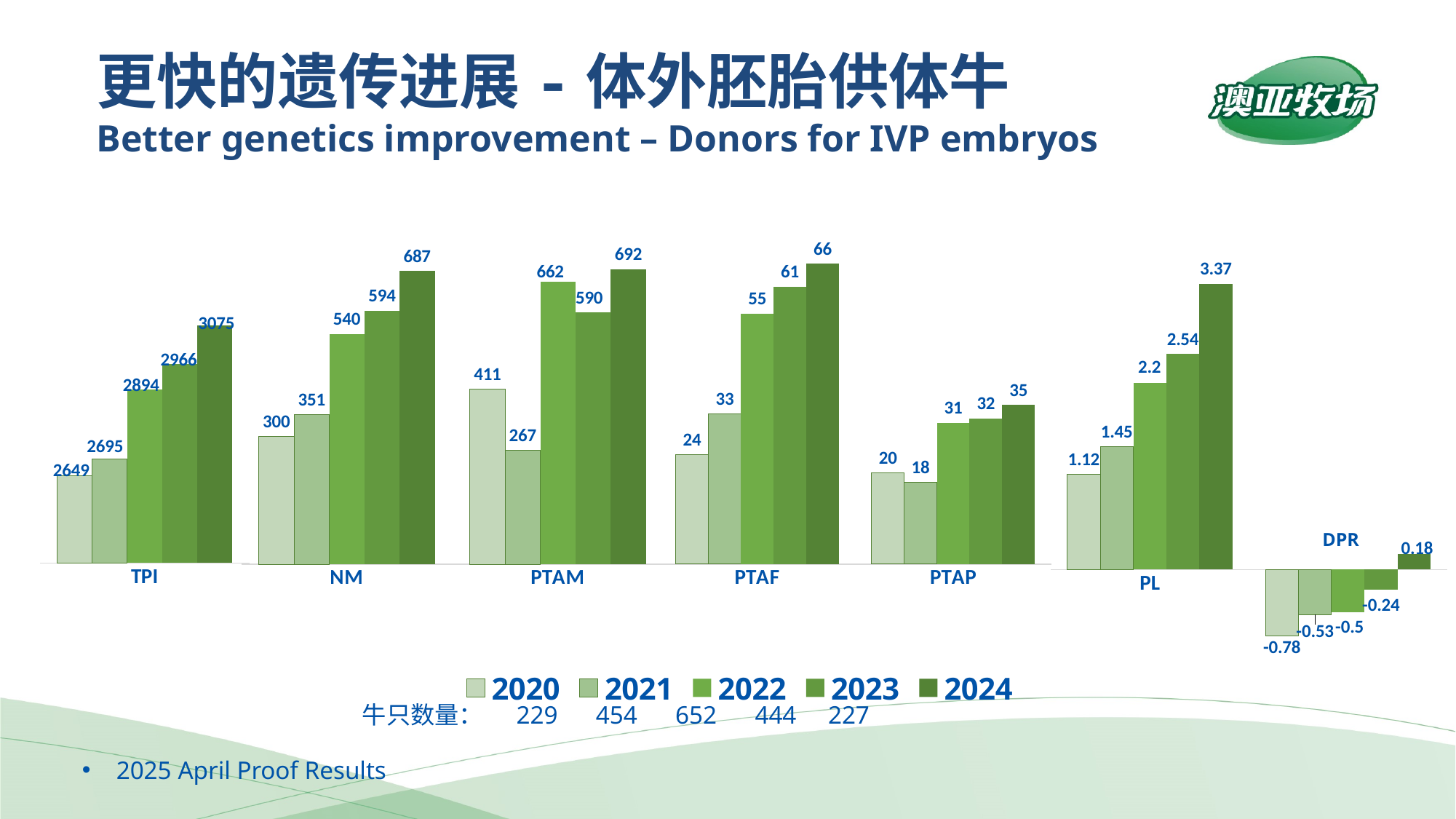
Which year has the lowest PTAP value? 2021 What kind of chart is shown on the slide? Bar chart Which year has the highest PL value? 2024 What is the difference between the NM value for 2024 and the NM value for 2020? 387 What is the NM value for 2022? 540 How many series does the legend list? 5 Do the PTAF values rise or fall from 2020 to 2024? Rise What is the DPR value for 2020? -0.78 Which is larger, the PTAM value for 2020 or for 2021? 2020 What is the PTAM value for 2021? 267 What is the TPI value for 2024? 3075 What is the PTAF value for 2023? 61